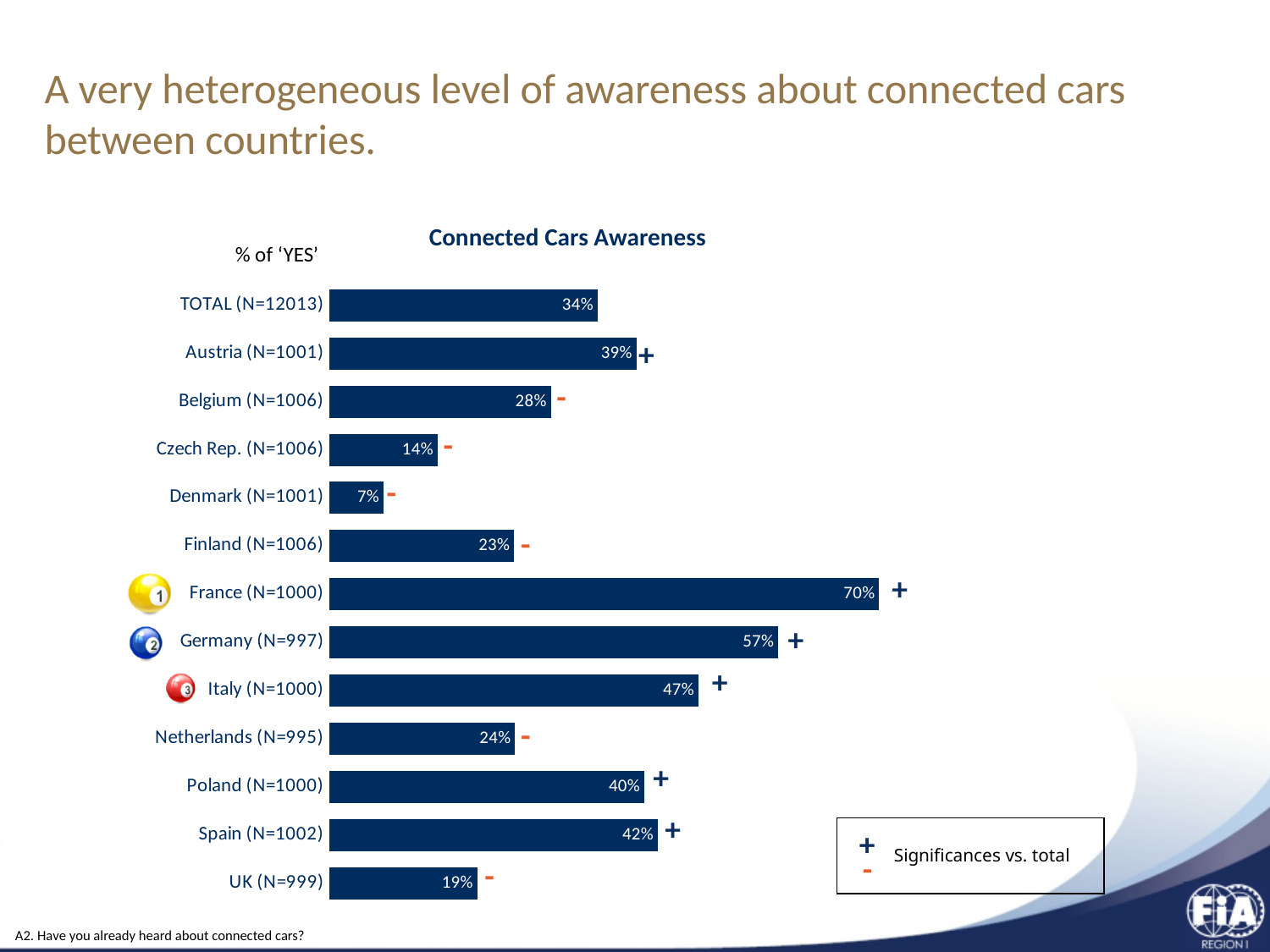
How many bars are shown in the Connected Cars Awareness chart? 13 What is the difference between the values for Germany (N=997) and Italy (N=1000)? 10% What is the value for Denmark (N=1001) in the Connected Cars Awareness chart? 7% What is the value for UK (N=999) in the Connected Cars Awareness chart? 19% What is the value for TOTAL (N=12013) in the Connected Cars Awareness chart? 34% Which has a higher value, Spain (N=1002) or Poland (N=1000)? Spain (N=1002) Which country has the lowest level of connected cars awareness? Denmark (N=1001) What is the difference between the value for Austria (N=1001) and the TOTAL (N=12013)? 5% What is the title of the chart? Connected Cars Awareness Which country has the highest level of connected cars awareness? France (N=1000) What is the value for France (N=1000) in the Connected Cars Awareness chart? 70% What kind of chart is shown on the slide? Bar chart